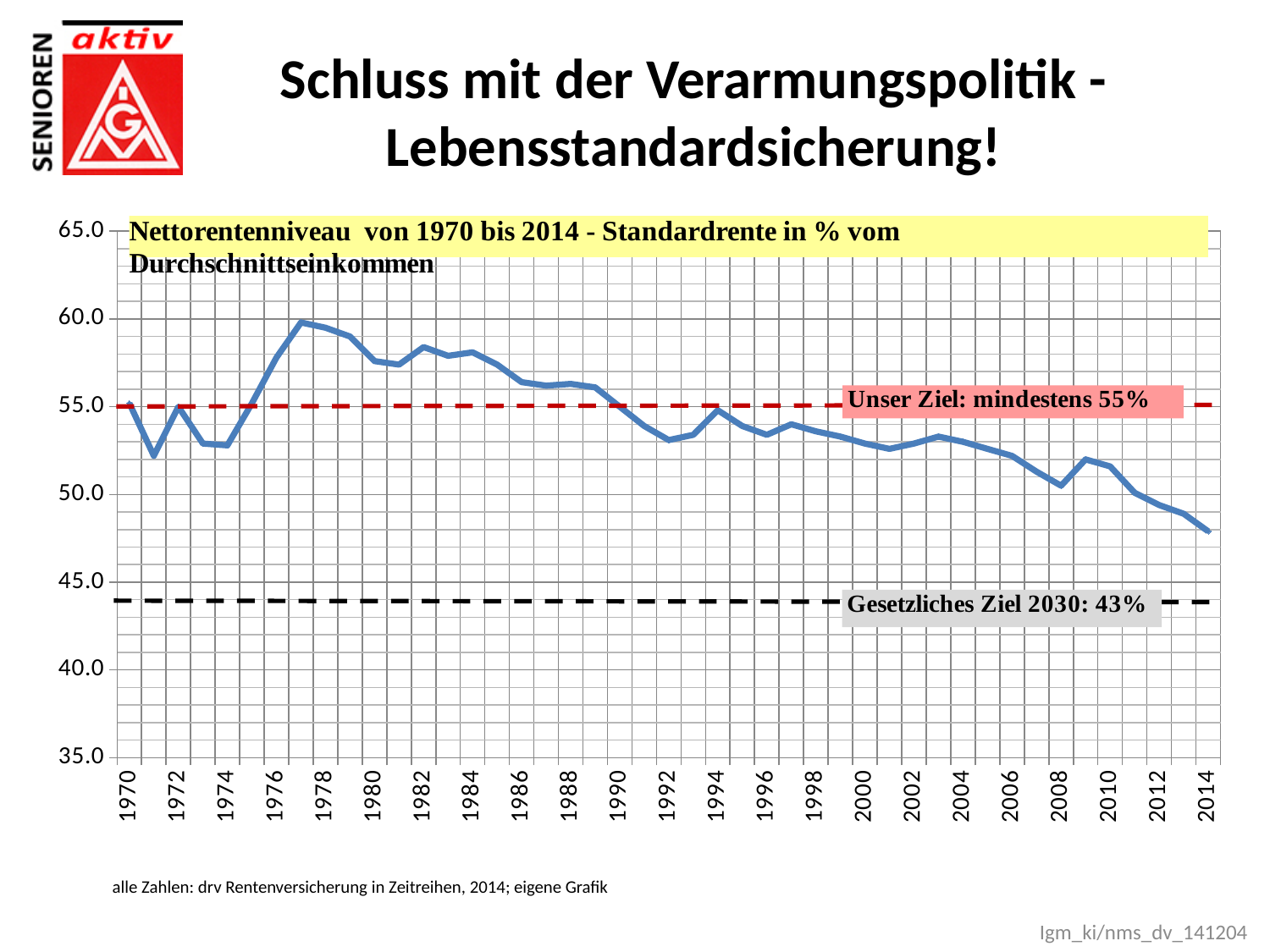
Is the value for 1971 greater or less than 55? less Does the net pension level rise or fall between 1990 and 2014? fall What kind of chart is shown on the slide? line chart Is the value for 1977 greater or less than 55? greater Is the value for 2000 greater or less than 55? less In which year is the plotted net pension level at its lowest? 2014 Which is larger, the value for 1982 or the value for 2012? 1982 What is the title of the chart? Nettorentenniveau von 1970 bis 2014 - Standardrente in % vom Durchschnittseinkommen What value does the red dashed line labelled "Unser Ziel" mark? mindestens 55%